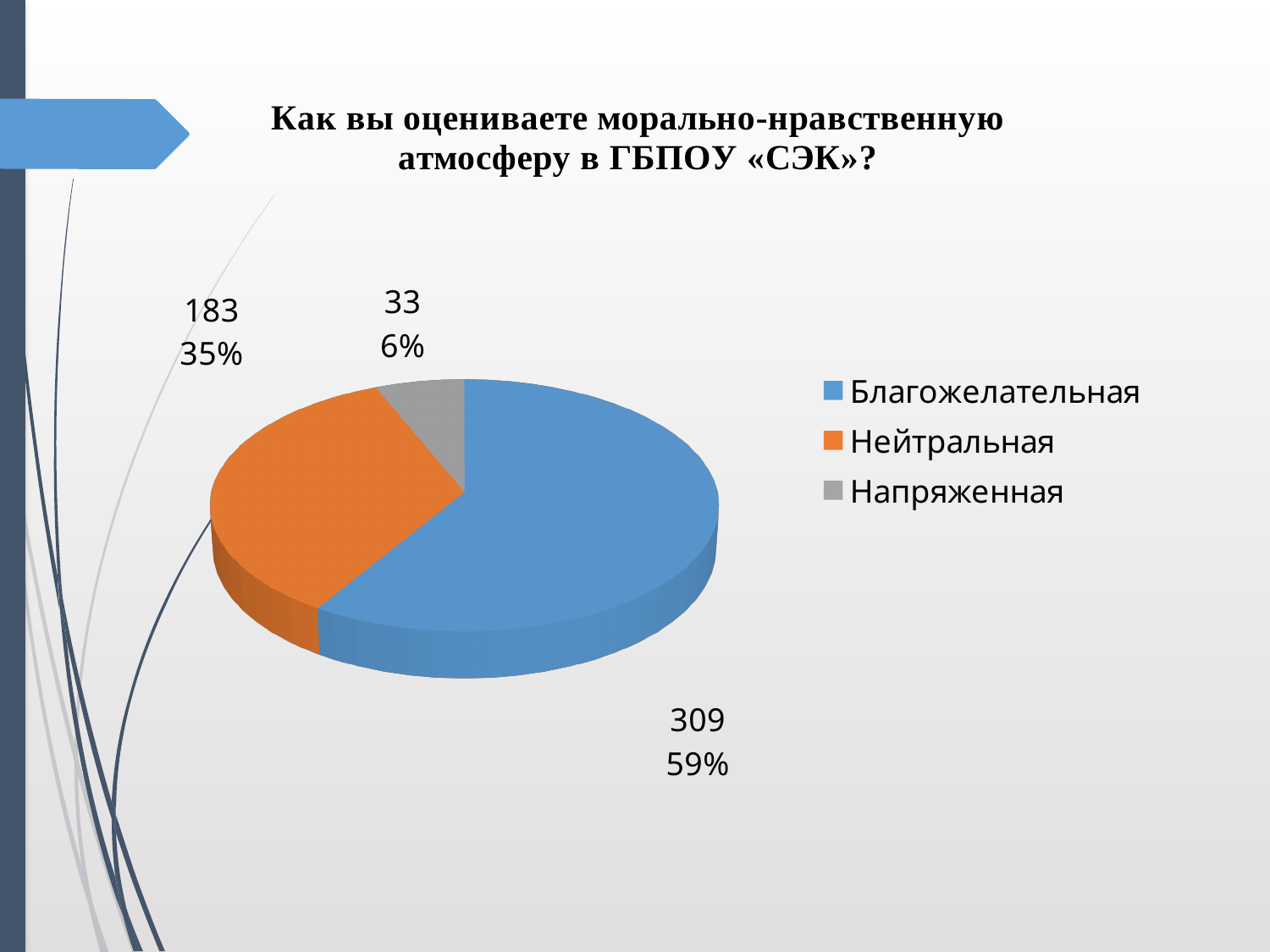
How many slices does the pie chart have? 3 Which category has the largest slice? Благожелательная What is the value for Нейтральная? 183 What is the value for Благожелательная? 309 Which category has the smallest slice? Напряженная What kind of chart is shown on the slide? pie chart What share of the pie does Напряженная take? 6% What is the value for Напряженная? 33 Which colour represents Нейтральная in the pie chart? orange What is the difference between the values for Благожелательная and Нейтральная? 126 What share of the pie does Благожелательная take? 59% How many entries does the legend list? 3